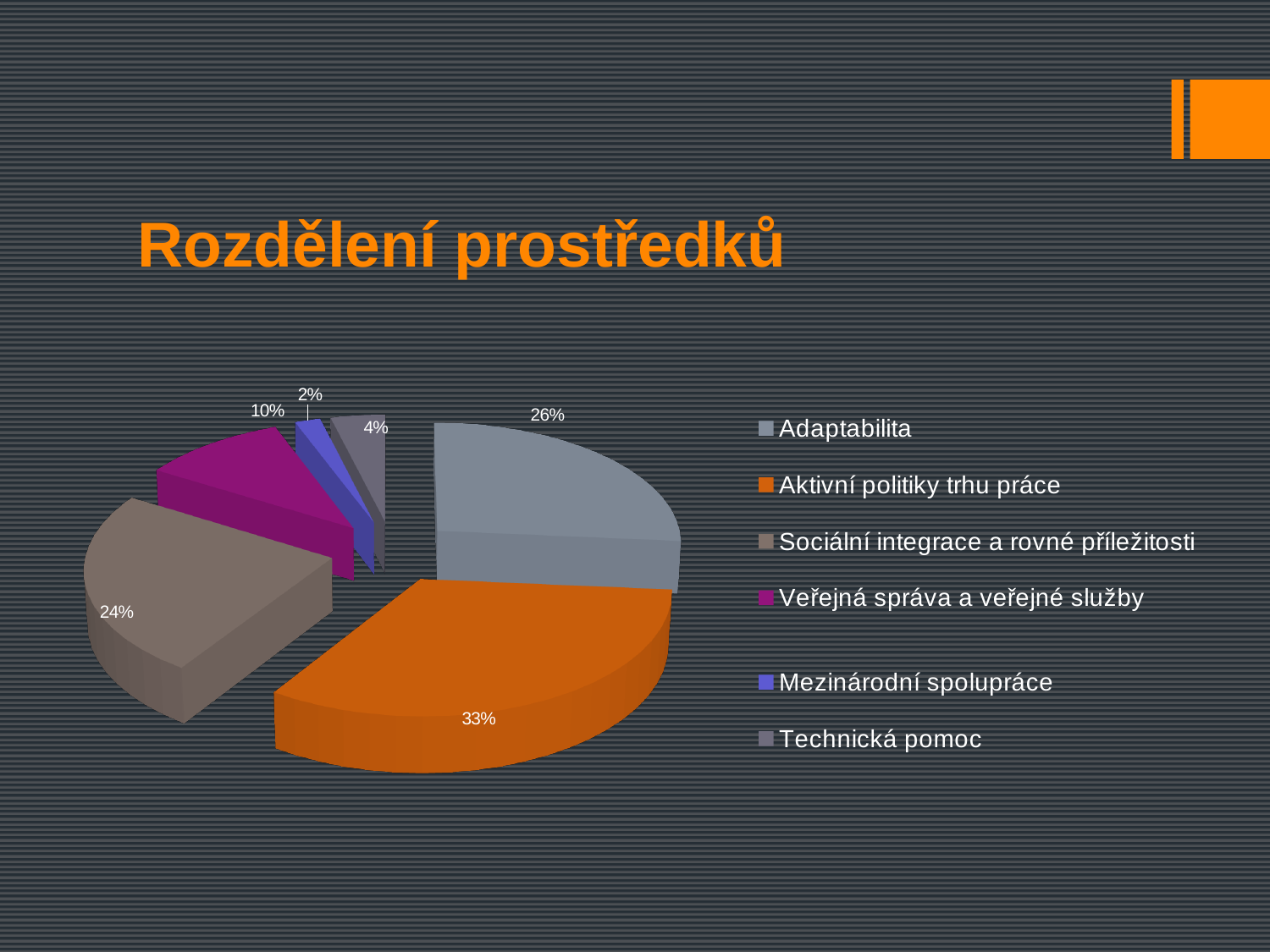
Which category has the smallest slice of the pie? Mezinárodní spolupráce What share of the pie does Veřejná správa a veřejné služby have? 10% What kind of chart is shown on the slide? Pie chart How many categories does the pie chart have? 6 What is the difference in percentage points between Aktivní politiky trhu práce and Adaptabilita? 7 What is the title of the slide containing the pie chart? Rozdělení prostředků What share of the pie does Aktivní politiky trhu práce have? 33% Which is larger, the share for Adaptabilita or the share for Sociální integrace a rovné příležitosti? Adaptabilita What share of the pie does Technická pomoc have? 4% Which category has the largest slice of the pie? Aktivní politiky trhu práce